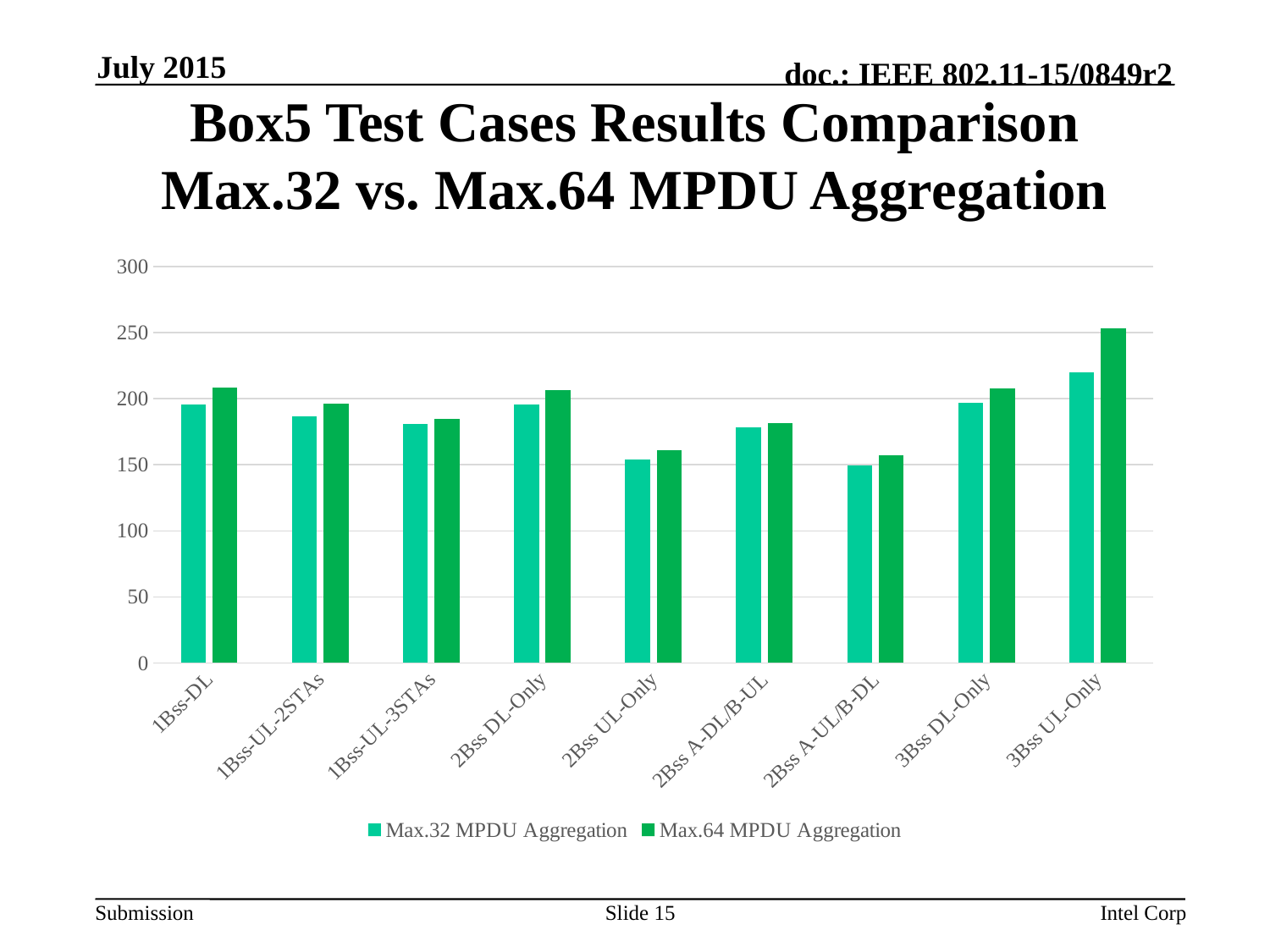
What kind of chart is shown on the slide? bar chart Which test case has the highest value for Max.64 MPDU Aggregation? 3Bss UL-Only How many test case categories are shown on the x axis? 9 How many series does the legend list? 2 Which test case has the highest value for Max.32 MPDU Aggregation? 3Bss UL-Only Is the Max.32 MPDU Aggregation value for 3Bss UL-Only greater or less than 200? greater Is the Max.64 MPDU Aggregation value for 1Bss-DL greater or less than 200? greater Is the Max.32 MPDU Aggregation value for 2Bss A-DL/B-UL greater or less than 200? less Which test case has the lowest value for Max.32 MPDU Aggregation? 2Bss A-UL/B-DL Which is larger: the Max.64 MPDU Aggregation value for 1Bss-DL or for 2Bss UL-Only? 1Bss-DL What is the title of the chart on the slide? Box5 Test Cases Results Comparison Max.32 vs. Max.64 MPDU Aggregation For 3Bss UL-Only, which series has the larger value, Max.32 MPDU Aggregation or Max.64 MPDU Aggregation? Max.64 MPDU Aggregation